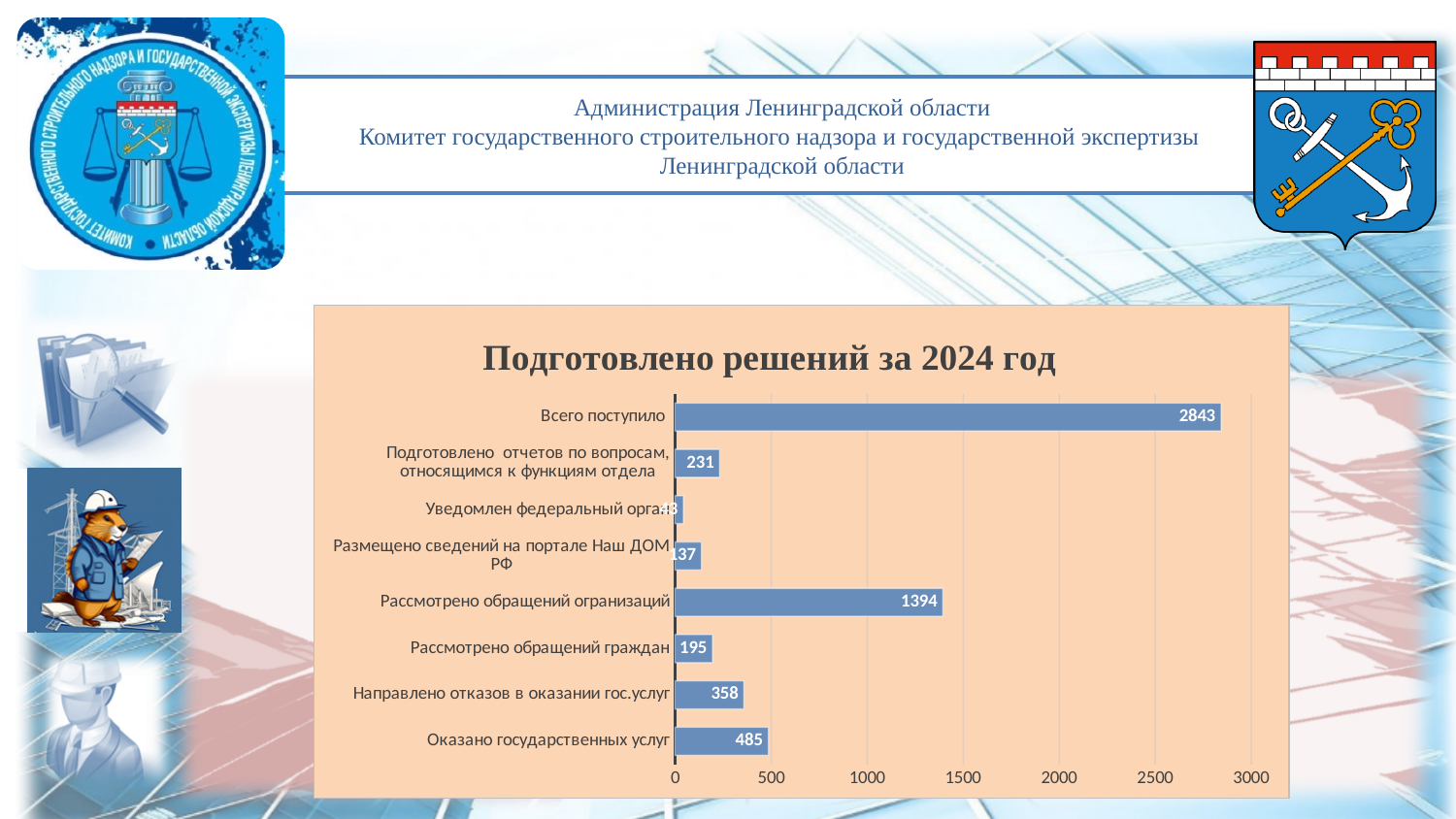
What is the value for "Направлено отказов в оказании гос.услуг"? 358 What is the title of the chart? Подготовлено решений за 2024 год What is the value for "Оказано государственных услуг"? 485 What is the difference between "Оказано государственных услуг" and "Направлено отказов в оказании гос.услуг"? 127 Which category has the highest value? Всего поступило What type of chart is shown on the slide? bar chart How many categories are shown in the chart? 8 What is the value for "Рассмотрено обращений организаций"? 1394 Which is larger: "Рассмотрено обращений организаций" or "Подготовлено отчетов по вопросам, относящимся к функциям отдела"? Рассмотрено обращений организаций What is the value for "Рассмотрено обращений граждан"? 195 What is the value for "Всего поступило"? 2843 Which category has the lowest value? Уведомлен федеральный орган